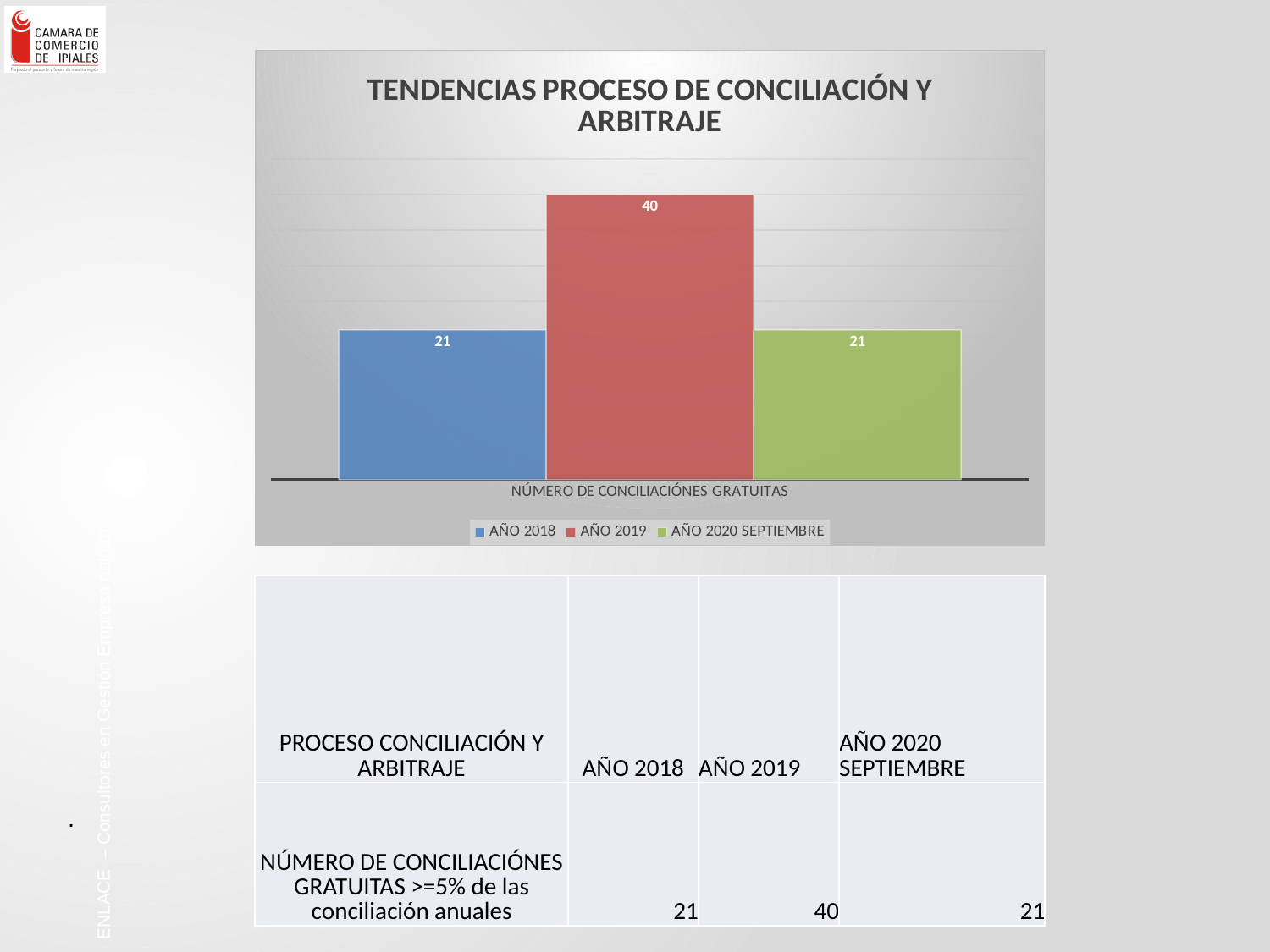
What is the difference between the values for AÑO 2019 and AÑO 2018? 19 Do the values for AÑO 2018 and AÑO 2020 SEPTIEMBRE differ? No, both are 21 What is the total of the three values shown in the chart? 82 What is the value for AÑO 2018 in the chart? 21 What is the category label shown on the x axis of the chart? NÚMERO DE CONCILIACIÓNES GRATUITAS What is the value for AÑO 2020 SEPTIEMBRE in the chart? 21 What is the title of the chart? TENDENCIAS PROCESO DE CONCILIACIÓN Y ARBITRAJE Which is larger, the value for AÑO 2019 or the value for AÑO 2020 SEPTIEMBRE? AÑO 2019 What kind of chart is shown on the slide? bar chart Which series has the highest value in the chart? AÑO 2019 What is the value for AÑO 2019 in the chart? 40 How many series does the legend list? 3